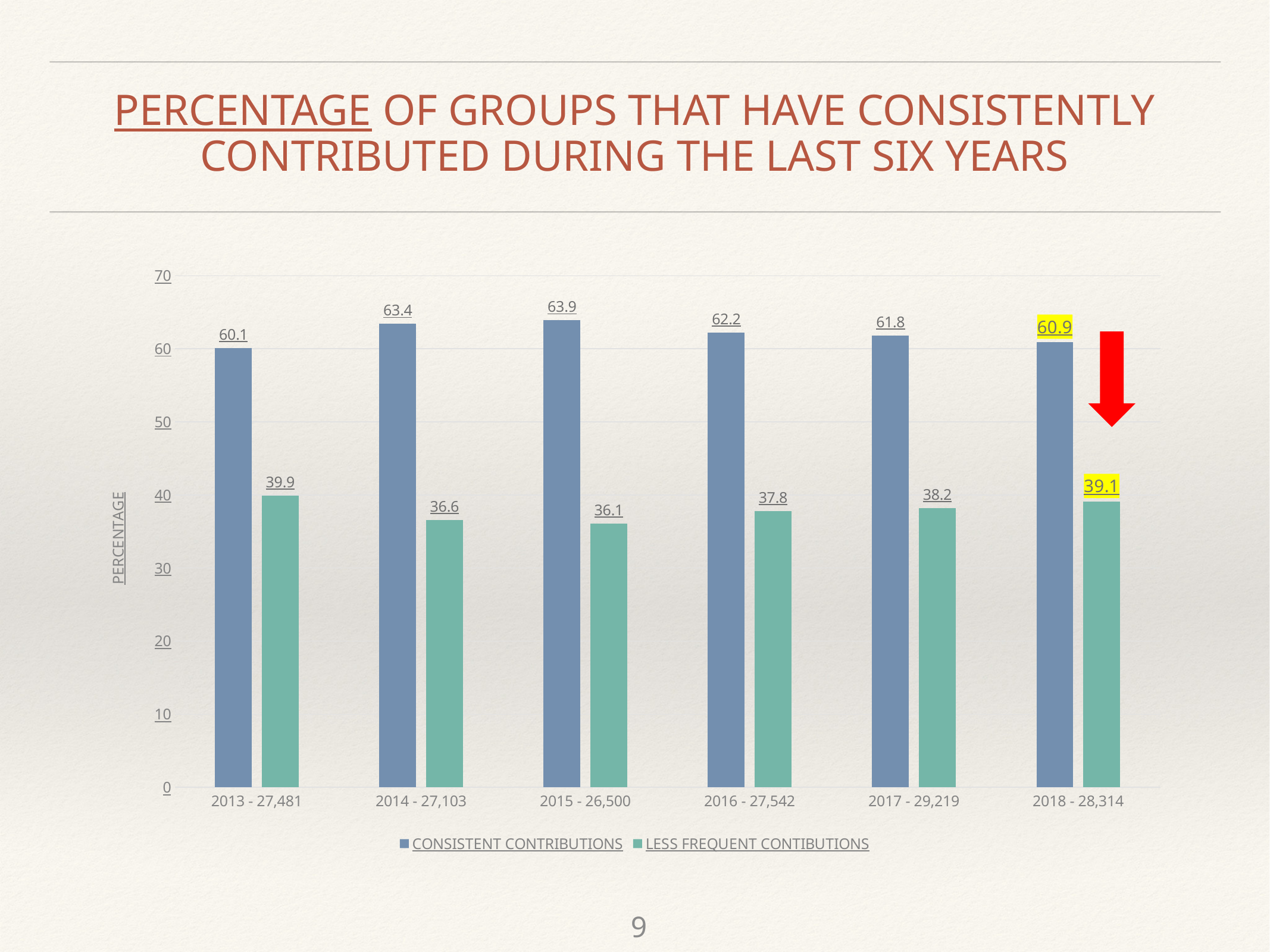
Which is larger: LESS FREQUENT CONTIBUTIONS in 2013 - 27,481 or in 2016 - 27,542? 2013 - 27,481 What is the label of the y axis? PERCENTAGE How many years are shown on the x axis? 6 Which year has the lowest value for LESS FREQUENT CONTIBUTIONS? 2015 - 26,500 Is the value for CONSISTENT CONTRIBUTIONS in 2014 - 27,103 greater or less than 60? greater What is the value for LESS FREQUENT CONTIBUTIONS in 2015 - 26,500? 36.1 What kind of chart is shown on the slide? bar chart What is the difference between CONSISTENT CONTRIBUTIONS and LESS FREQUENT CONTIBUTIONS in 2017 - 29,219? 23.6 What is the value for CONSISTENT CONTRIBUTIONS in 2013 - 27,481? 60.1 Which year has the highest value for CONSISTENT CONTRIBUTIONS? 2015 - 26,500 What is the value for CONSISTENT CONTRIBUTIONS in 2018 - 28,314? 60.9 How many series does the legend list? 2